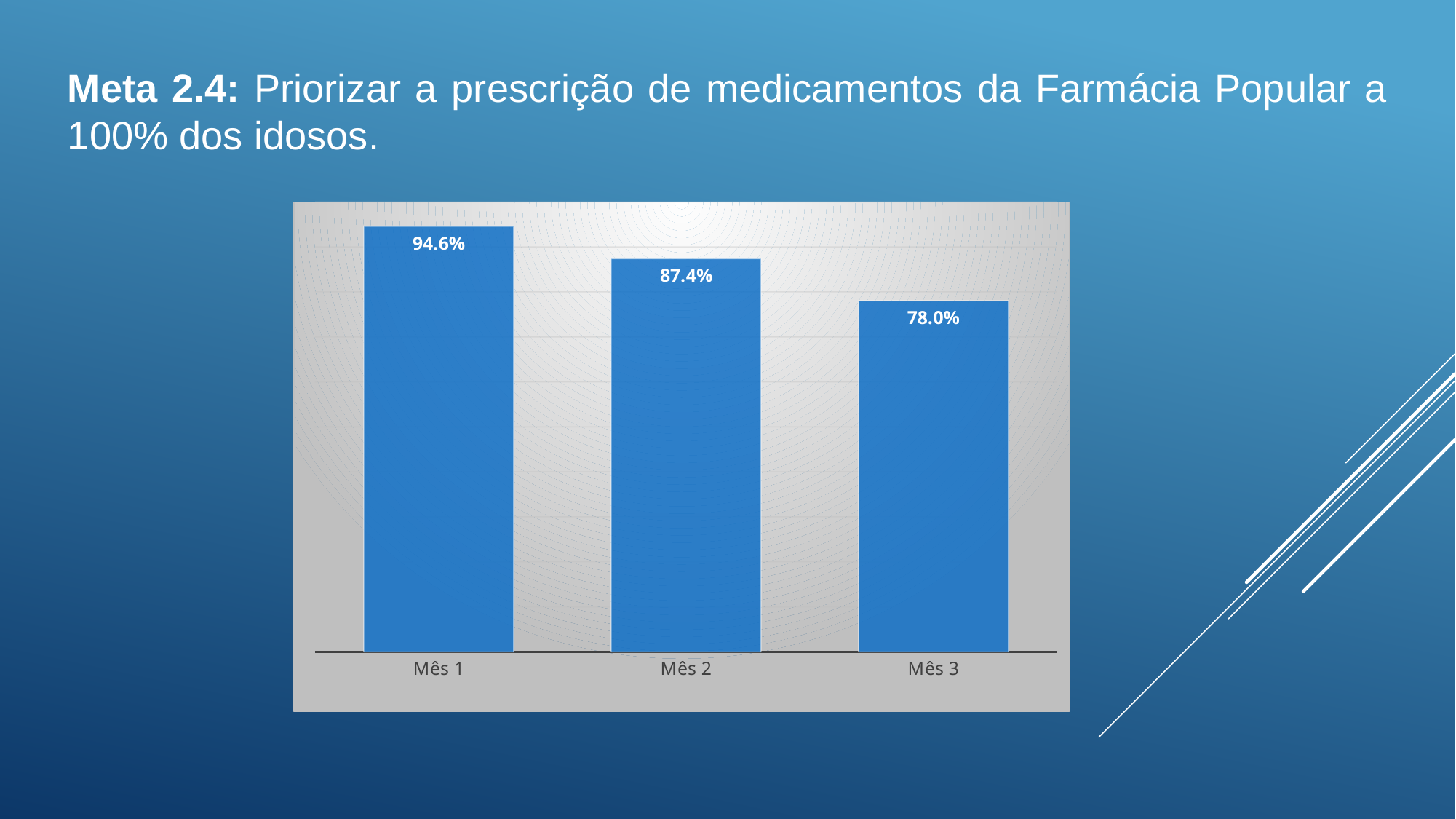
What is the difference between the values for Mês 1 and Mês 2? 7.2% What is the value for Mês 2? 87.4% What kind of chart is shown on the slide? Bar chart What is the difference between the values for Mês 2 and Mês 3? 9.4% Which month has the lowest value? Mês 3 What is the value for Mês 1? 94.6% Which month has the highest value? Mês 1 Do the values rise or fall from Mês 1 to Mês 3? Fall What is the difference between the values for Mês 1 and Mês 3? 16.6% How many months are shown on the chart? 3 Which is larger, the value for Mês 2 or the value for Mês 3? Mês 2 What is the value for Mês 3? 78.0%